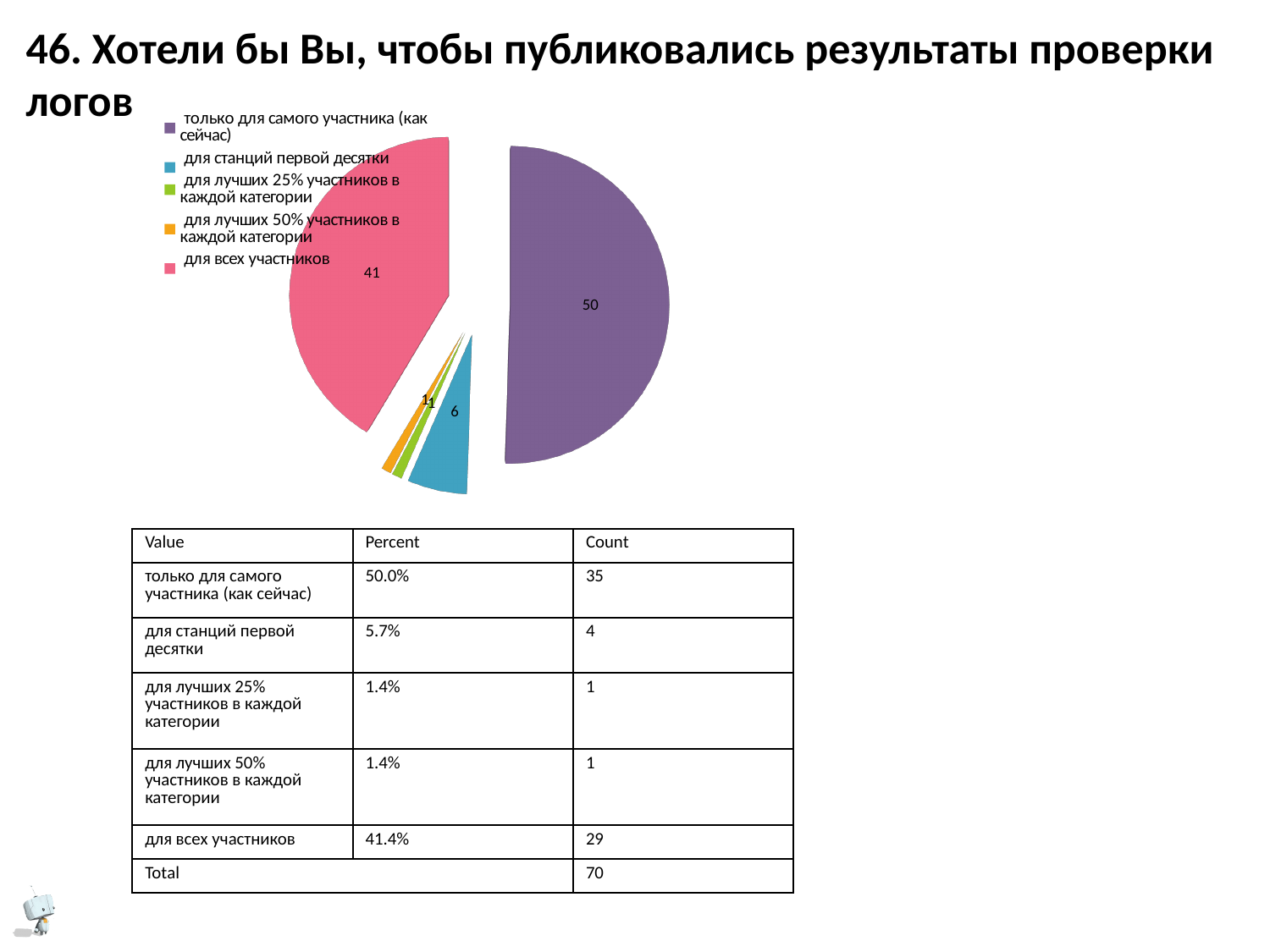
Which slice is larger in the pie chart: "для всех участников" or "для станций первой десятки"? для всех участников What kind of chart is shown on the slide? pie chart Which category has the largest slice in the pie chart? только для самого участника (как сейчас) What is the data label on the pie slice for "для всех участников"? 41 What is the data label on the pie slice for "для станций первой десятки"? 6 How many entries does the legend of the pie chart list? 5 What colour is the slice for "только для самого участника (как сейчас)" in the pie chart? purple What colour is the slice for "для всех участников" in the pie chart? pink How many slices does the pie chart have? 5 What is the difference between the data labels for "для всех участников" and "для станций первой десятки" in the pie chart? 35 What is the difference between the data labels for "только для самого участника (как сейчас)" and "для всех участников" in the pie chart? 9 What is the data label on the pie slice for "только для самого участника (как сейчас)"? 50